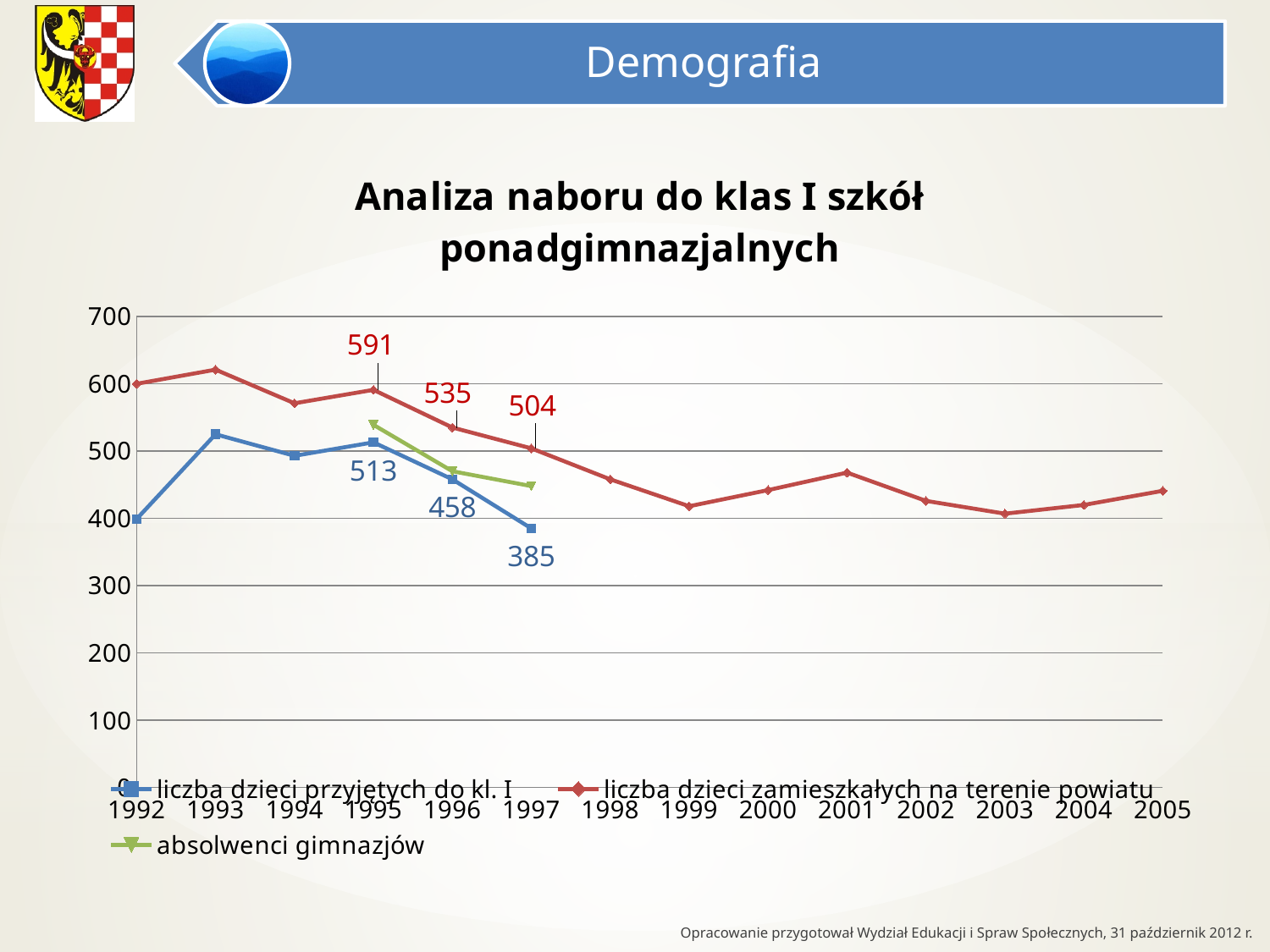
In 1997, which series has the larger value: 'liczba dzieci zamieszkałych na terenie powiatu' or 'liczba dzieci przyjętych do kl. I'? liczba dzieci zamieszkałych na terenie powiatu Does 'liczba dzieci przyjętych do kl. I' rise or fall from 1995 to 1997? fall What is the value for 'liczba dzieci przyjętych do kl. I' in 1997? 385 What is the value for 'liczba dzieci zamieszkałych na terenie powiatu' in 1996? 535 What is the title of the chart? Analiza naboru do klas I szkół ponadgimnazjalnych What is the value for 'liczba dzieci zamieszkałych na terenie powiatu' in 1995? 591 How many years are shown on the x axis? 14 How many series does the legend list? 3 What is the difference between 'liczba dzieci zamieszkałych na terenie powiatu' and 'liczba dzieci przyjętych do kl. I' in 1995? 78 Is the value for 'liczba dzieci zamieszkałych na terenie powiatu' in 1993 greater or less than 600? greater By how much did 'liczba dzieci przyjętych do kl. I' fall from 1996 to 1997? 73 What kind of chart is shown on the slide? line chart